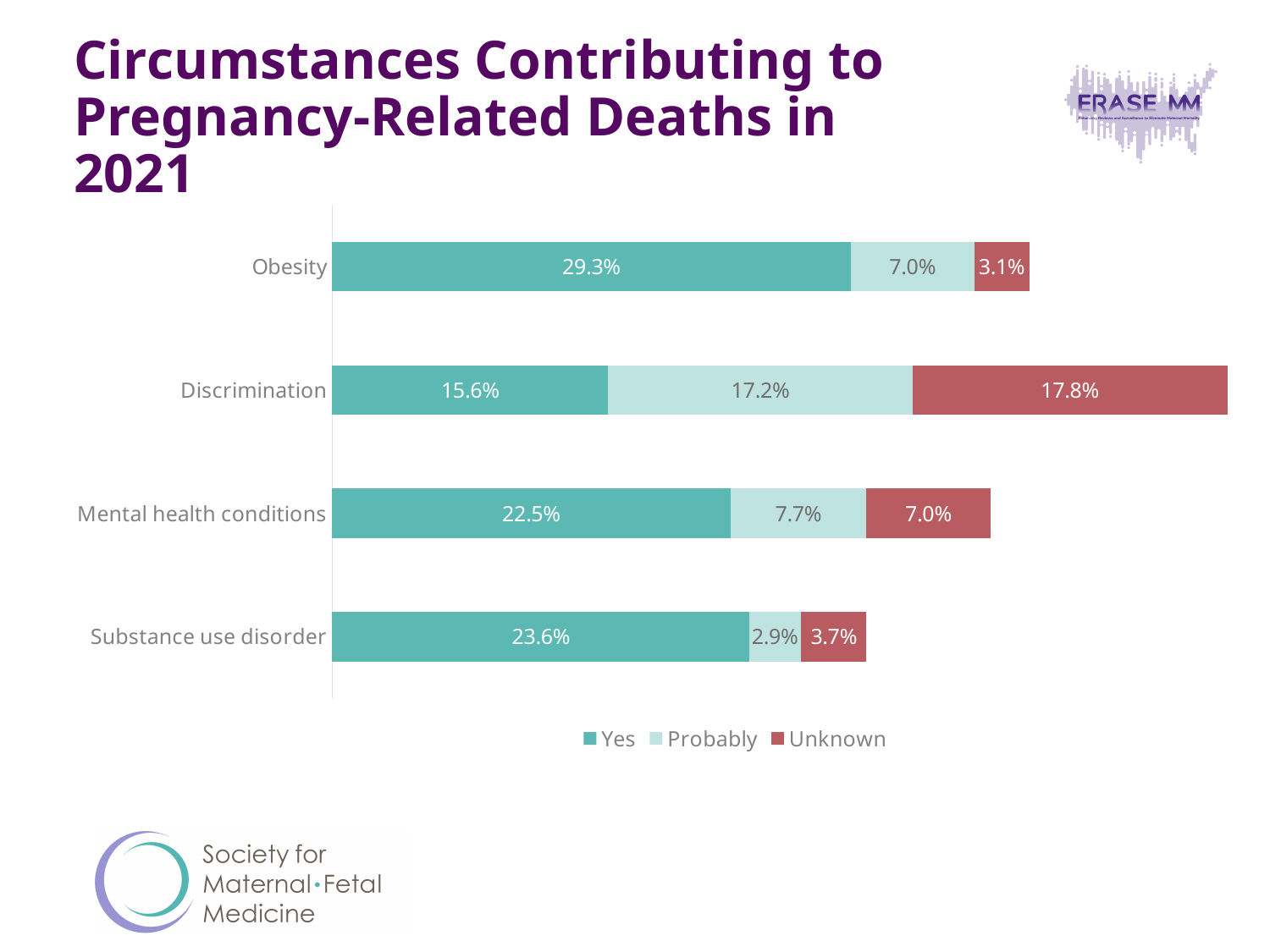
What is the "Unknown" value for Discrimination? 17.8% What is the "Probably" value for Substance use disorder? 2.9% Which is larger: the "Yes" value for Mental health conditions or the "Yes" value for Substance use disorder? Substance use disorder What is the total of the stacked bar for Discrimination? 50.6% What kind of chart is shown on the slide? Stacked bar chart What is the difference between the "Yes" values for Obesity and Discrimination? 13.7% What is the "Unknown" value for Mental health conditions? 7.0% Which category has the highest "Yes" value? Obesity What is the "Yes" value for Obesity? 29.3% How many categories are shown in the chart? 4 Which category has the lowest "Probably" value? Substance use disorder How many series does the legend list? 3